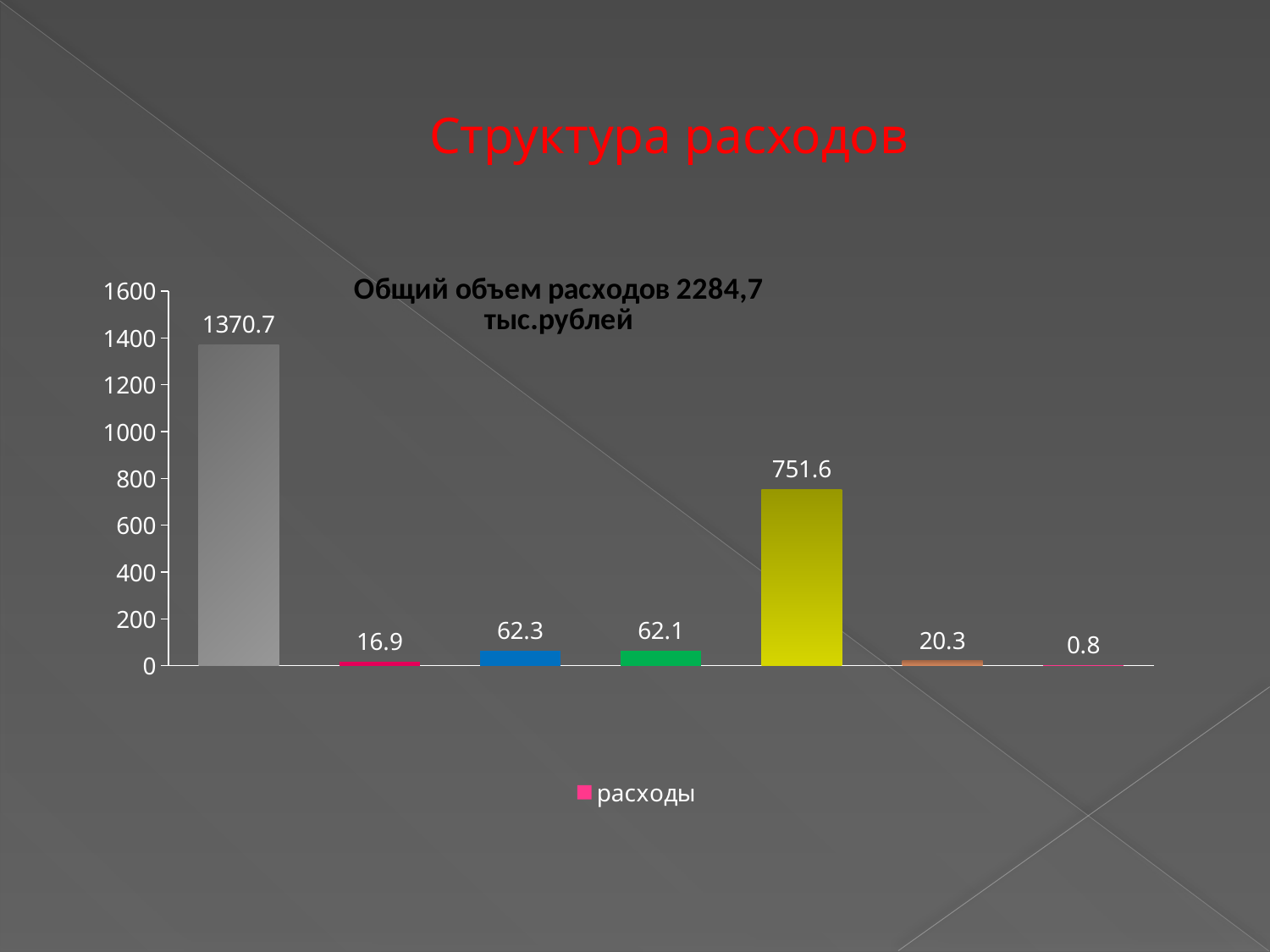
What is the lowest value shown in the chart? 0.8 What is the title printed inside the chart area? Общий объем расходов 2284,7 тыс.рублей How many bars are plotted in the chart? 7 What is the name of the series shown in the chart legend? расходы What is the difference between the first bar (1370.7) and the yellow bar (751.6)? 619.1 What is the value of the first (leftmost, grey) bar? 1370.7 What is the value of the last (rightmost) bar? 0.8 How many series does the chart legend list? 1 What is the highest value shown in the chart? 1370.7 What is the value of the yellow bar (fifth from the left)? 751.6 What type of chart is shown on the slide? bar chart Which is larger, the blue bar (third from left) or the green bar (fourth from left)? the blue bar (62.3)